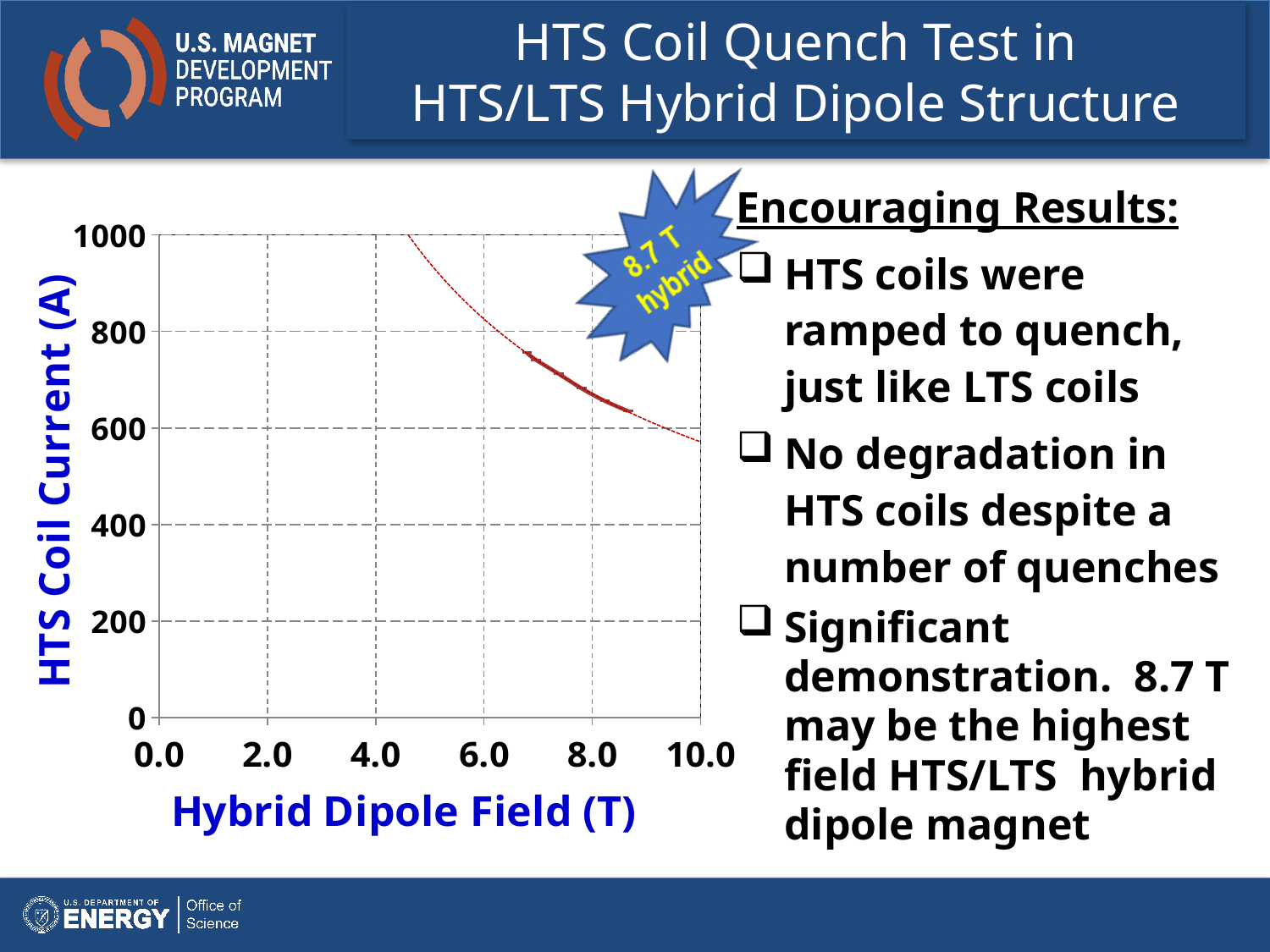
Is the highest hybrid dipole field reached by the plotted data points greater or less than 8.0 T? greater What kind of chart is shown on the slide? scatter chart with a trend line Which has the higher HTS coil current: the data point near 7.0 T or the data point near 8.5 T? the data point near 7.0 T Is the HTS coil current at a hybrid dipole field of 7.0 T greater or less than 600 A? greater Is the HTS coil current at a hybrid dipole field of 7.0 T greater or less than 800 A? less As the hybrid dipole field increases along the x axis, does the HTS coil current rise or fall? fall What is the title of the y axis of the chart? HTS Coil Current (A) What is the title of the x axis of the chart? Hybrid Dipole Field (T) What is the maximum value shown on the y axis of the chart? 1000